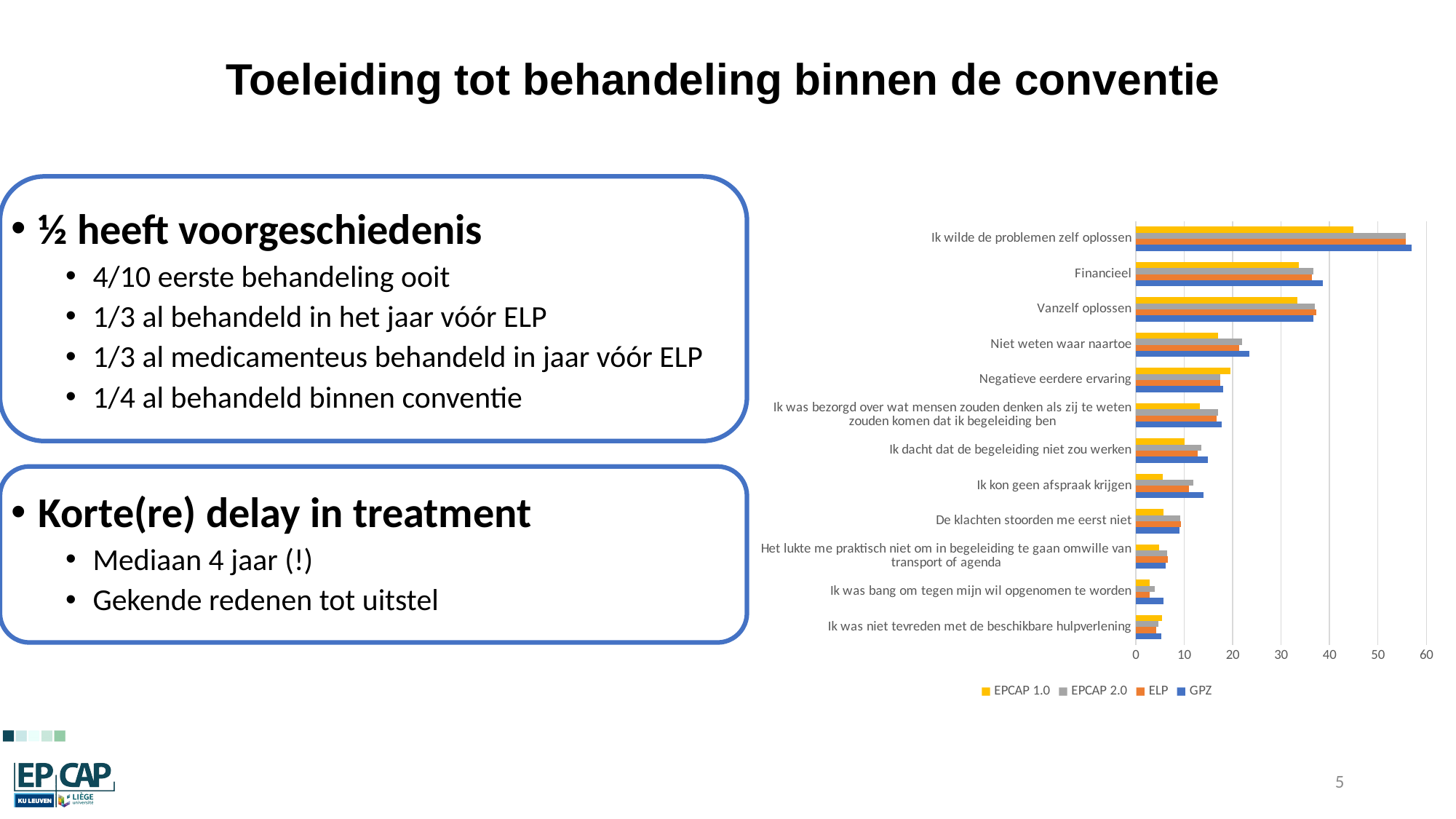
Is the GPZ value for 'Financieel' greater or less than 30? greater Which category has the highest values across all series in the chart? Ik wilde de problemen zelf oplossen Which category has the highest EPCAP 1.0 value? Ik wilde de problemen zelf oplossen How many categories (reasons) are listed on the vertical axis of the chart? 12 Is the GPZ value for 'Ik wilde de problemen zelf oplossen' greater or less than 50? greater Is the EPCAP 1.0 value for 'Ik wilde de problemen zelf oplossen' greater or less than 50? less For 'Ik kon geen afspraak krijgen', which is larger: the GPZ value or the EPCAP 1.0 value? GPZ Which colour represents the GPZ series in the chart? blue What kind of chart is shown on the right of the slide? bar chart How many series does the chart legend list? 4 For 'Niet weten waar naartoe', which is larger: the EPCAP 1.0 value or the GPZ value? GPZ